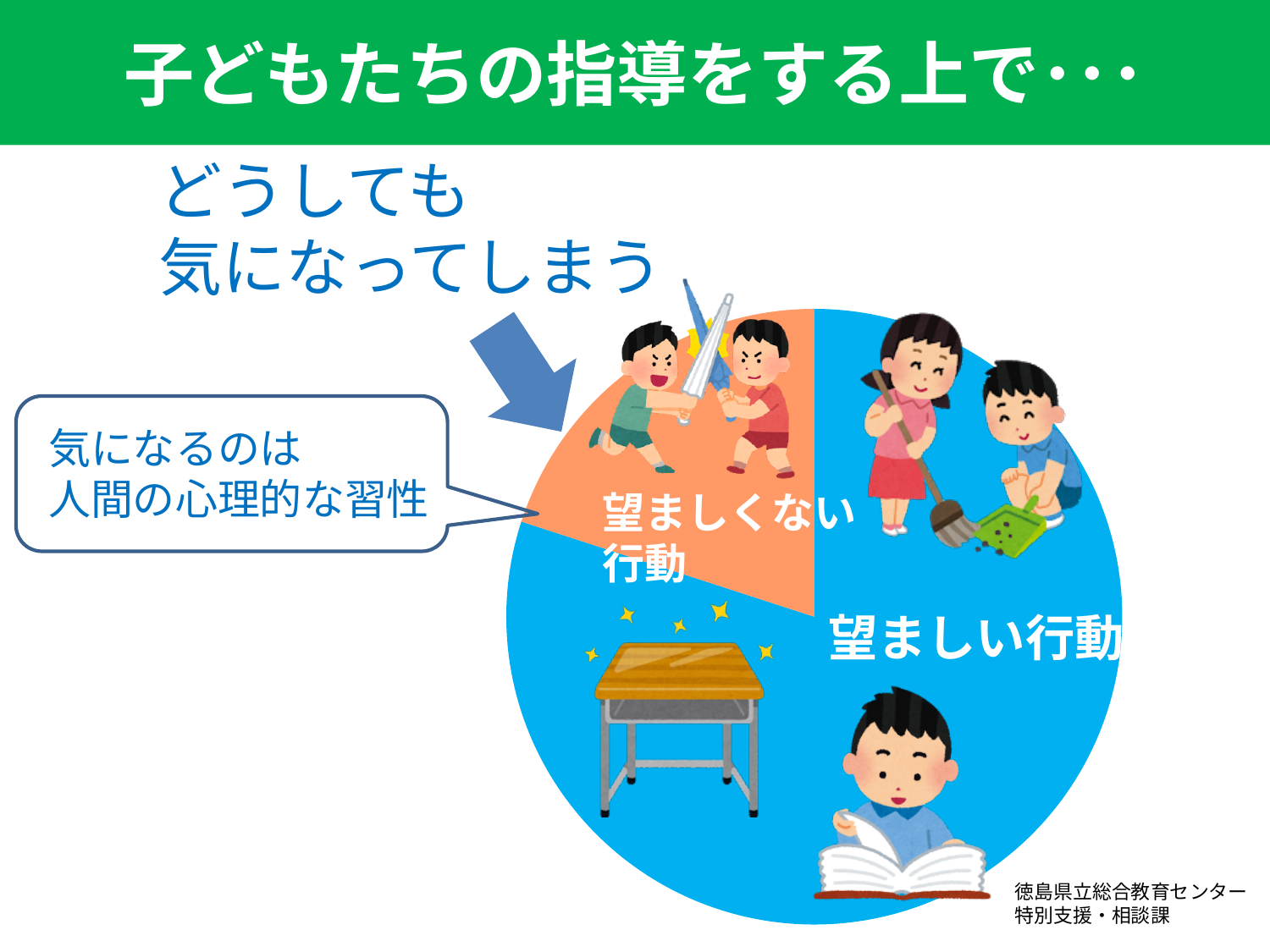
Is the 望ましくない行動 slice of the pie chart greater or less than half of the pie? less What kind of chart is shown on the slide? pie chart Which category takes up the largest share of the pie chart? 望ましい行動 How many slices does the pie chart have? 2 What colour is the 望ましい行動 slice of the pie chart? blue What colour is the 望ましくない行動 slice of the pie chart? orange Which category takes up the smallest share of the pie chart? 望ましくない行動 Which slice of the pie chart is larger, 望ましい行動 or 望ましくない行動? 望ましい行動 Is the 望ましい行動 slice of the pie chart greater or less than half of the pie? greater